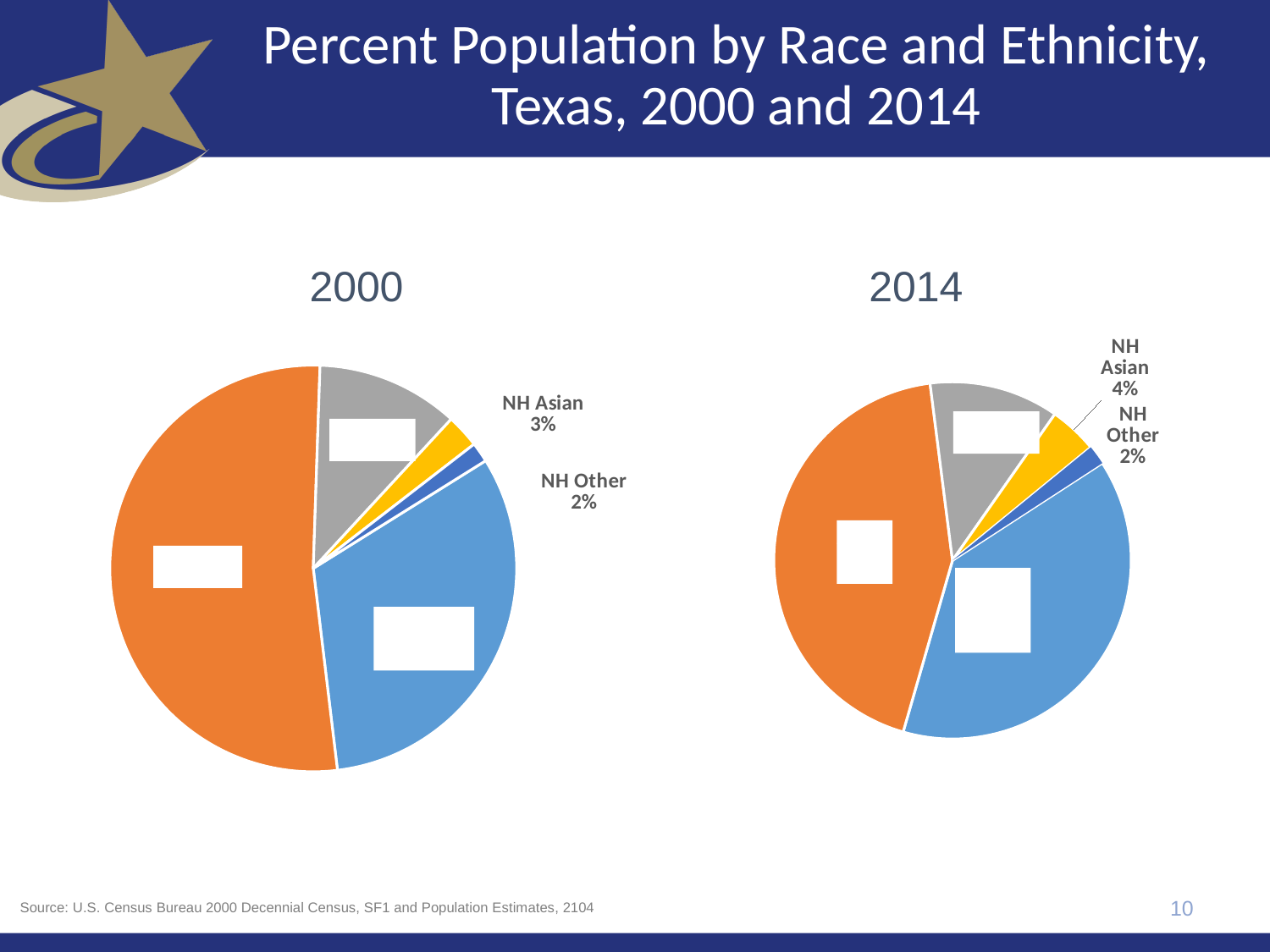
How many pie charts are shown on the slide? 2 In the 2014 pie chart, what is the difference between the NH Asian and NH Other percentages? 2% In the 2000 pie chart, which is larger, NH Asian or NH Other? NH Asian Comparing the 2000 and 2014 pie charts, in which year is the NH Asian share larger? 2014 In the 2014 pie chart, what percentage is labelled for NH Other? 2% In the 2000 pie chart, what percentage is labelled for NH Asian? 3% By how many percentage points did the NH Asian share change from the 2000 chart to the 2014 chart? 1% What kind of chart is used for the 2000 data? Pie chart How many slices does the 2014 pie chart have? 5 What is the title of the slide containing the two pie charts? Percent Population by Race and Ethnicity, Texas, 2000 and 2014 In the 2000 pie chart, what percentage is labelled for NH Other? 2% In the 2014 pie chart, what percentage is labelled for NH Asian? 4%